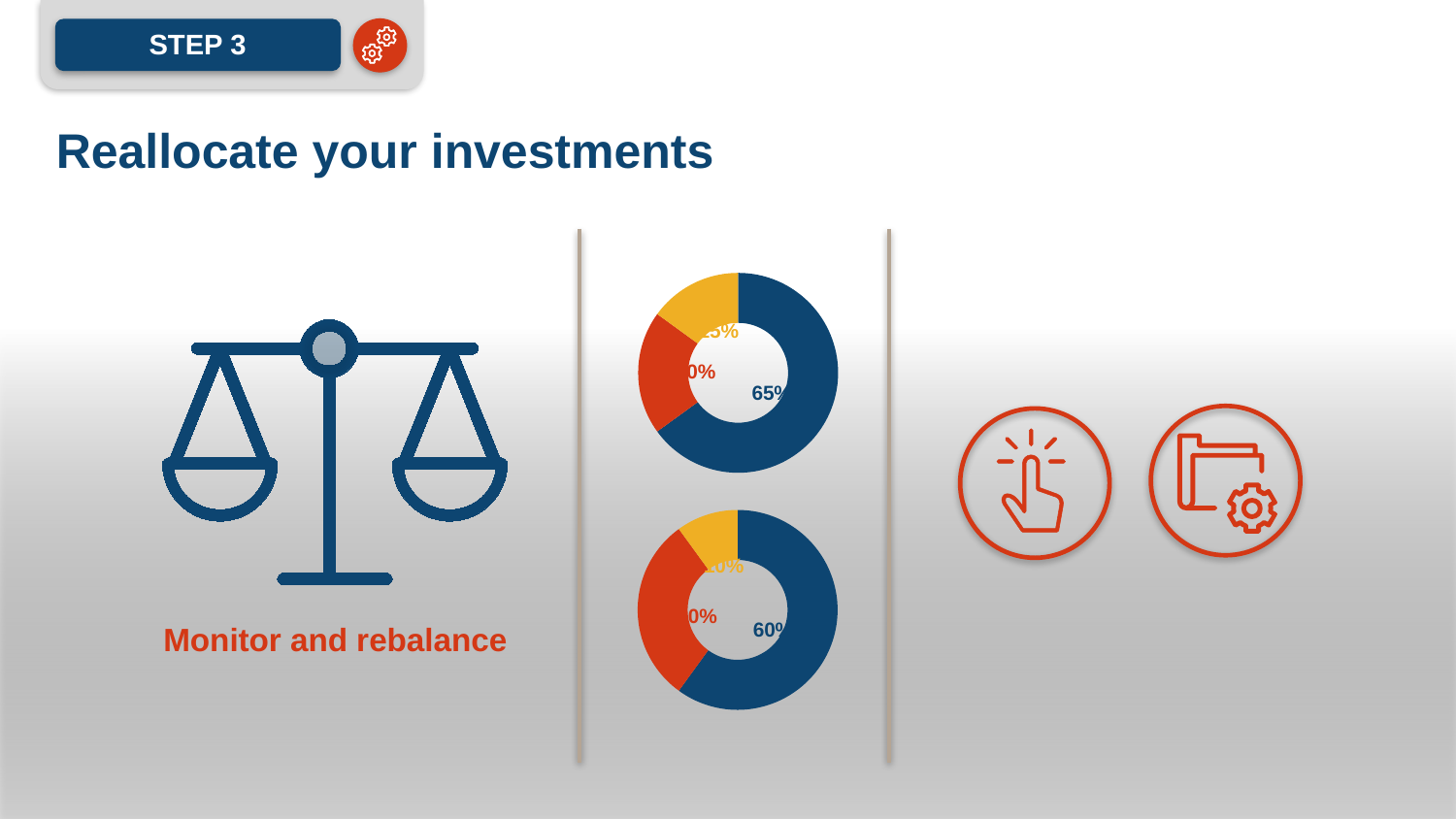
In the bottom doughnut chart, is the red slice larger or smaller than the yellow slice? Larger In the top doughnut chart, what percentage is shown on the dark blue slice? 65% In the bottom doughnut chart, which colour slice is the smallest? Yellow Which chart has the larger dark blue slice, the top doughnut chart or the bottom doughnut chart? The top doughnut chart How many slices does the bottom doughnut chart have? 3 What kind of chart is the bottom chart on the slide? Doughnut chart How many slices does the top doughnut chart have? 3 In the bottom doughnut chart, which colour slice is the largest? Dark blue In the bottom doughnut chart, what percentage is shown on the dark blue slice? 60% In the top doughnut chart, which colour slice is the largest? Dark blue What kind of chart is the top chart on the slide? Doughnut chart What is the difference between the dark blue slice in the top doughnut chart and the dark blue slice in the bottom doughnut chart? 5%